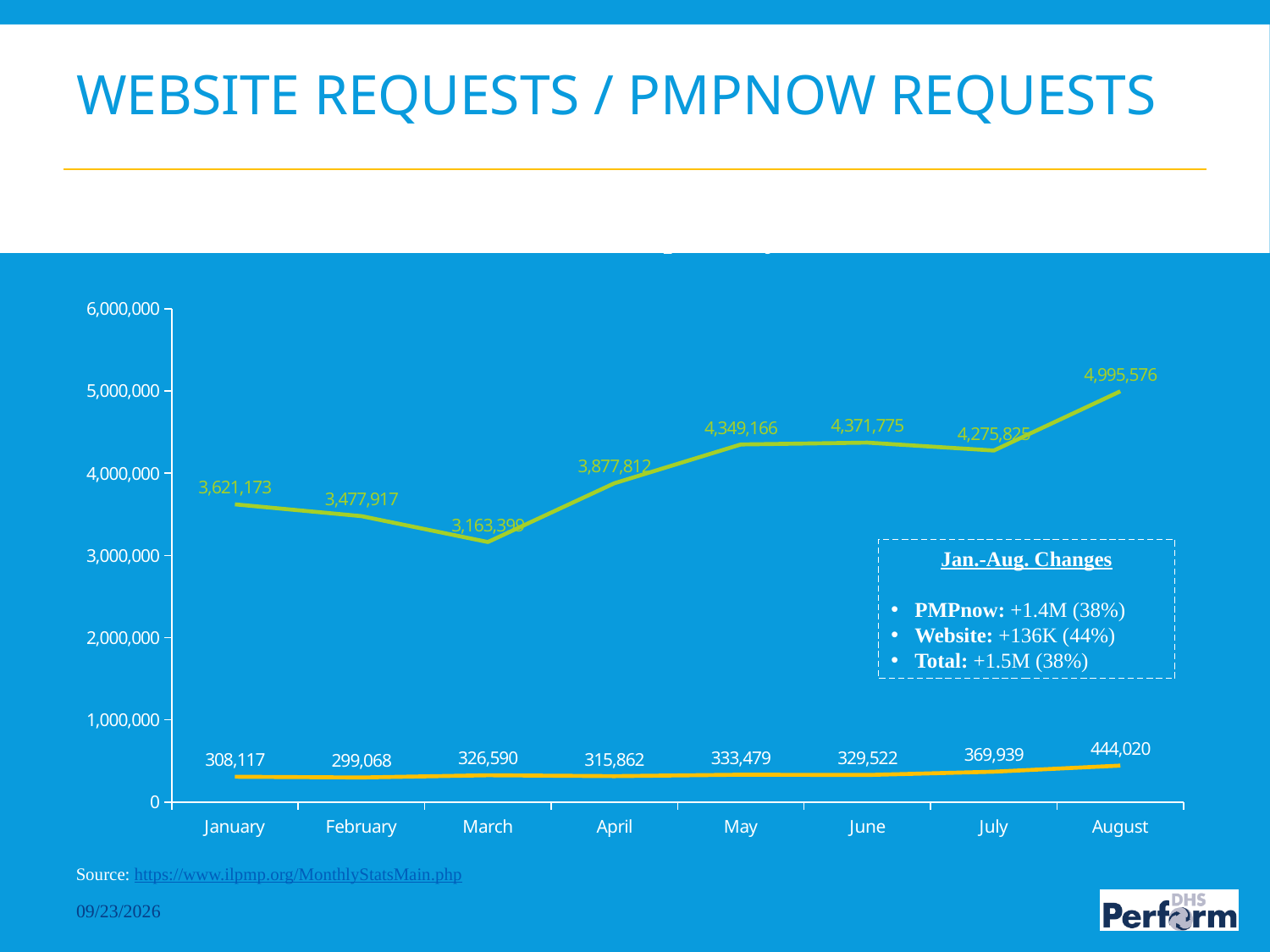
In which month does the lower (orange) line reach its highest value? August What is the difference between the upper (green) line's August value and its January value? 1,374,403 What is the value of the lower (orange) line in July? 369,939 What kind of chart is shown on the slide? Line chart What is the value of the upper (green) line in August? 4,995,576 How many months are plotted along the x axis? 8 In which month does the lower (orange) line have its lowest value? February What is the value of the lower (orange) line in January? 308,117 In which month does the upper (green) line have its lowest value? March For the upper (green) line, which is larger: the May value or the June value? June Is the value of the upper (green) line in April greater or less than 4,000,000? less What is the difference between the lower (orange) line's August value and its January value? 135,903